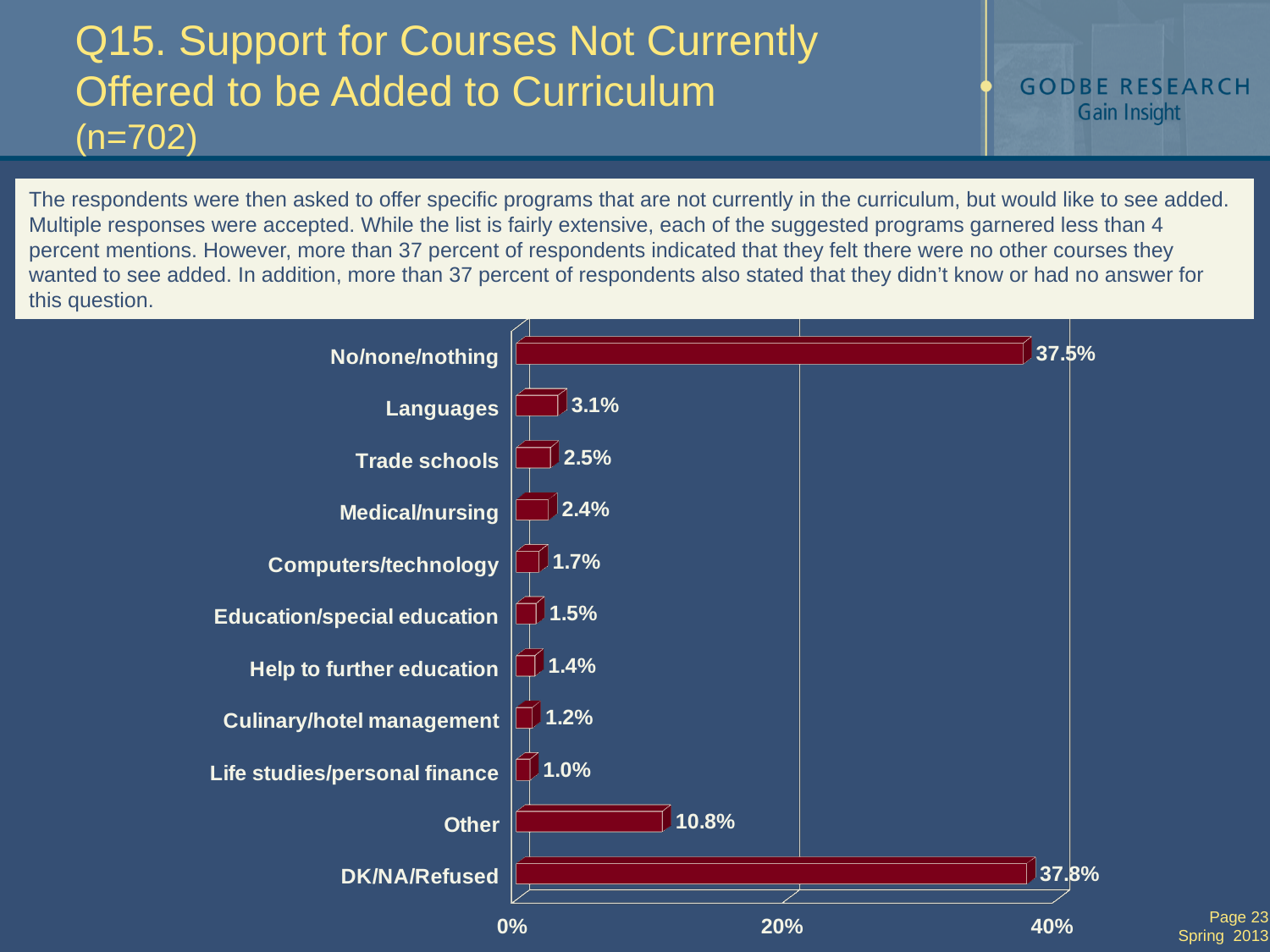
What percentage of respondents answered No/none/nothing? 37.5% What is the difference between the values for Trade schools and Medical/nursing? 0.1% What is the highest value shown on the horizontal axis? 40% What is the value for Languages? 3.1% How many categories are shown in the chart? 11 Which category has the highest value? DK/NA/Refused Which category has the lowest value? Life studies/personal finance What kind of chart is shown on the slide? Bar chart Which is larger, the value for Computers/technology or the value for Education/special education? Computers/technology What percentage is shown for Other? 10.8% What is the difference between the values for DK/NA/Refused and Other? 27.0% What is the value for Culinary/hotel management? 1.2%